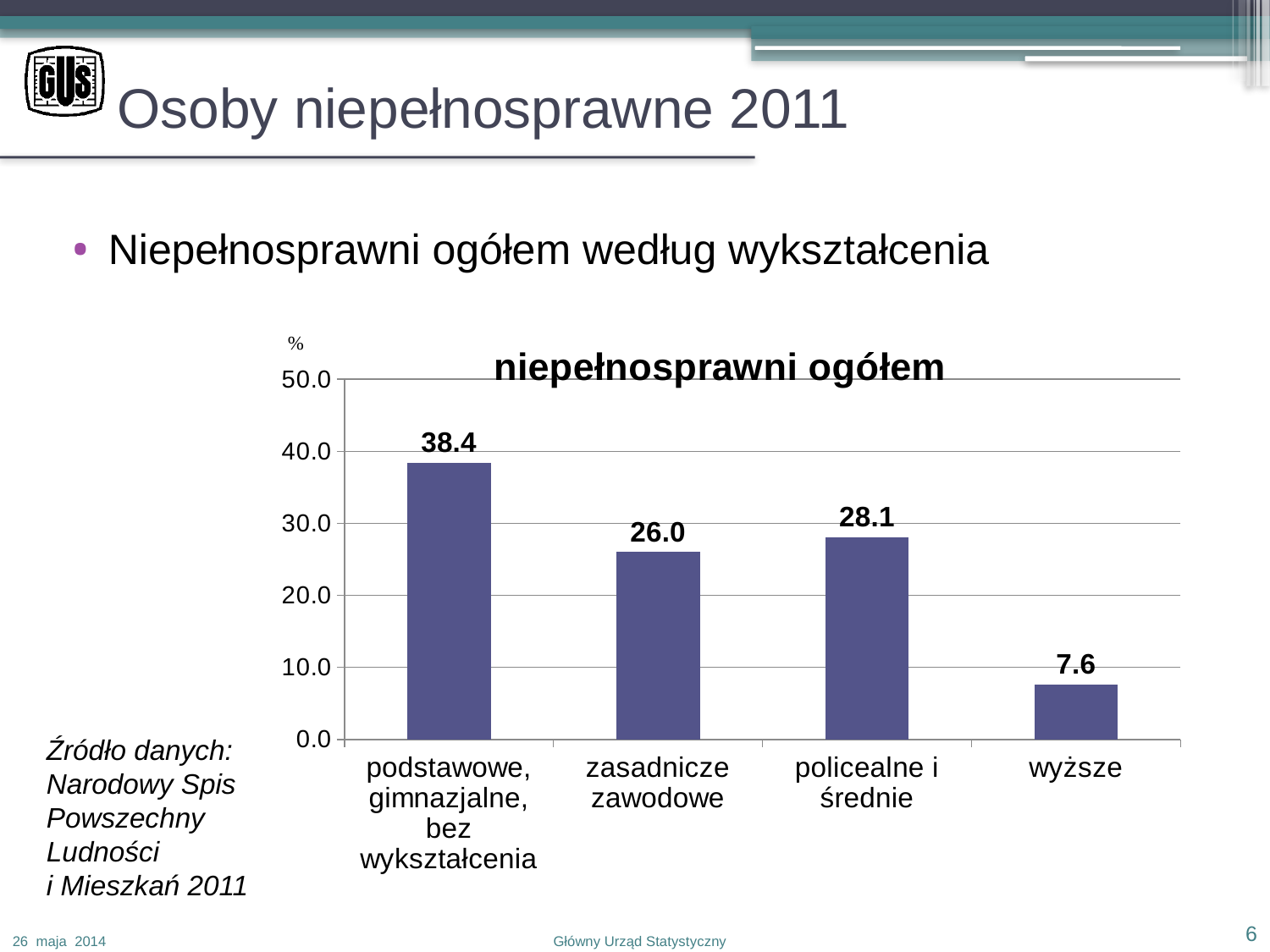
What is the value for 'policealne i średnie'? 28.1 Which category has the highest value? podstawowe, gimnazjalne, bez wykształcenia What is the difference between the values for 'podstawowe, gimnazjalne, bez wykształcenia' and 'wyższe'? 30.8 Which is larger, the value for 'policealne i średnie' or 'zasadnicze zawodowe'? policealne i średnie What kind of chart is shown? bar chart What is the value for 'zasadnicze zawodowe'? 26.0 How many categories are shown on the x axis? 4 What is the value for 'wyższe'? 7.6 What is the title of the chart? niepełnosprawni ogółem Is the value for 'podstawowe, gimnazjalne, bez wykształcenia' greater or less than 30.0? greater Which category has the lowest value? wyższe What is the difference between the values for 'policealne i średnie' and 'zasadnicze zawodowe'? 2.1